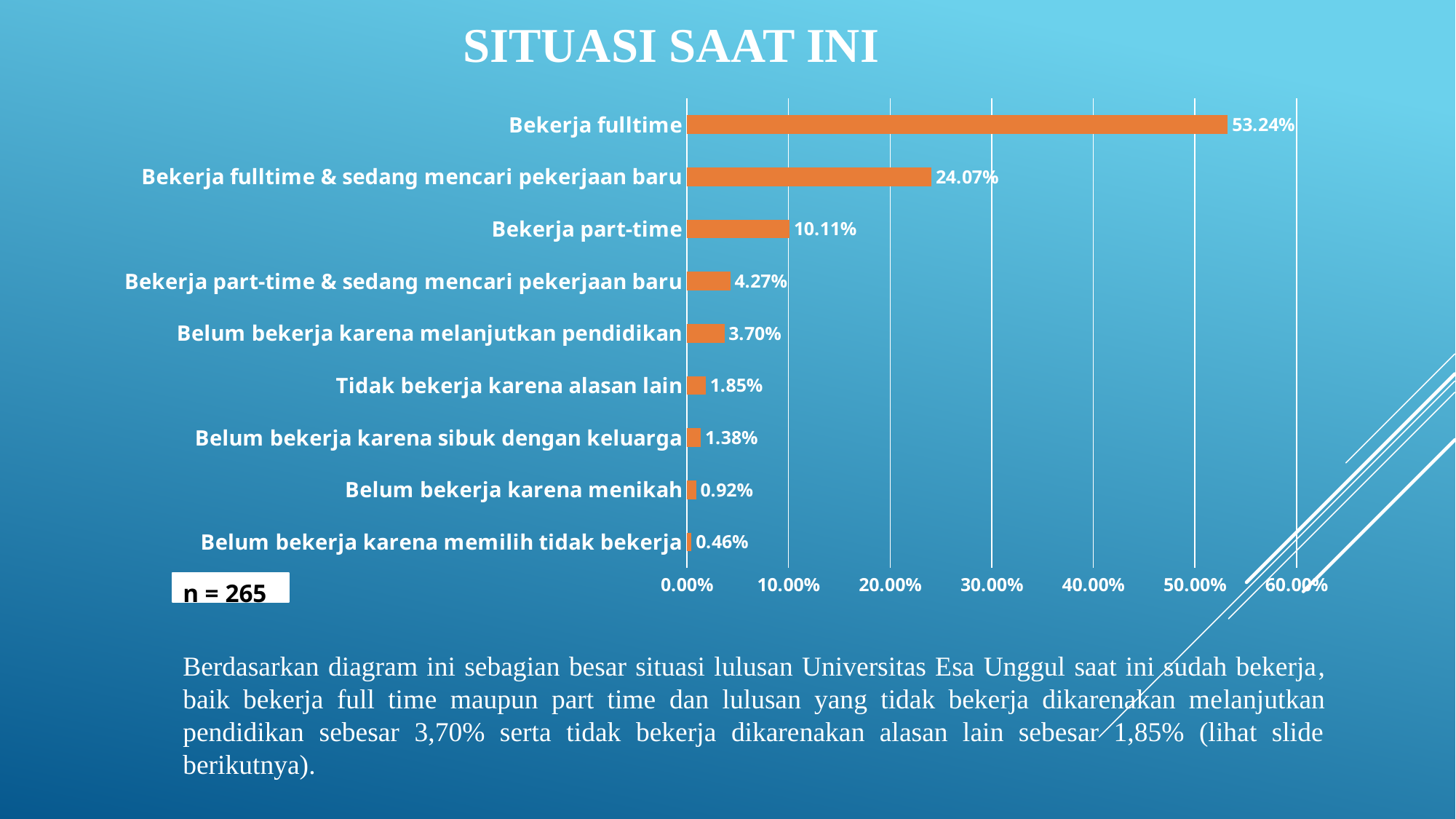
Which is larger, Bekerja part-time & sedang mencari pekerjaan baru or Tidak bekerja karena alasan lain? Bekerja part-time & sedang mencari pekerjaan baru What is the value for Bekerja fulltime? 53.24% What is the value for Belum bekerja karena menikah? 0.92% How many categories are shown in the chart? 9 What is the title of the slide containing the chart? SITUASI SAAT INI Is the value for Bekerja fulltime & sedang mencari pekerjaan baru greater or less than 20.00%? greater What kind of chart is shown on the slide? bar chart What is the difference between Bekerja fulltime and Bekerja fulltime & sedang mencari pekerjaan baru? 29.17% Which category has the lowest value? Belum bekerja karena memilih tidak bekerja What is the value for Bekerja part-time? 10.11% Which category has the highest value? Bekerja fulltime What is the value for Belum bekerja karena melanjutkan pendidikan? 3.70%